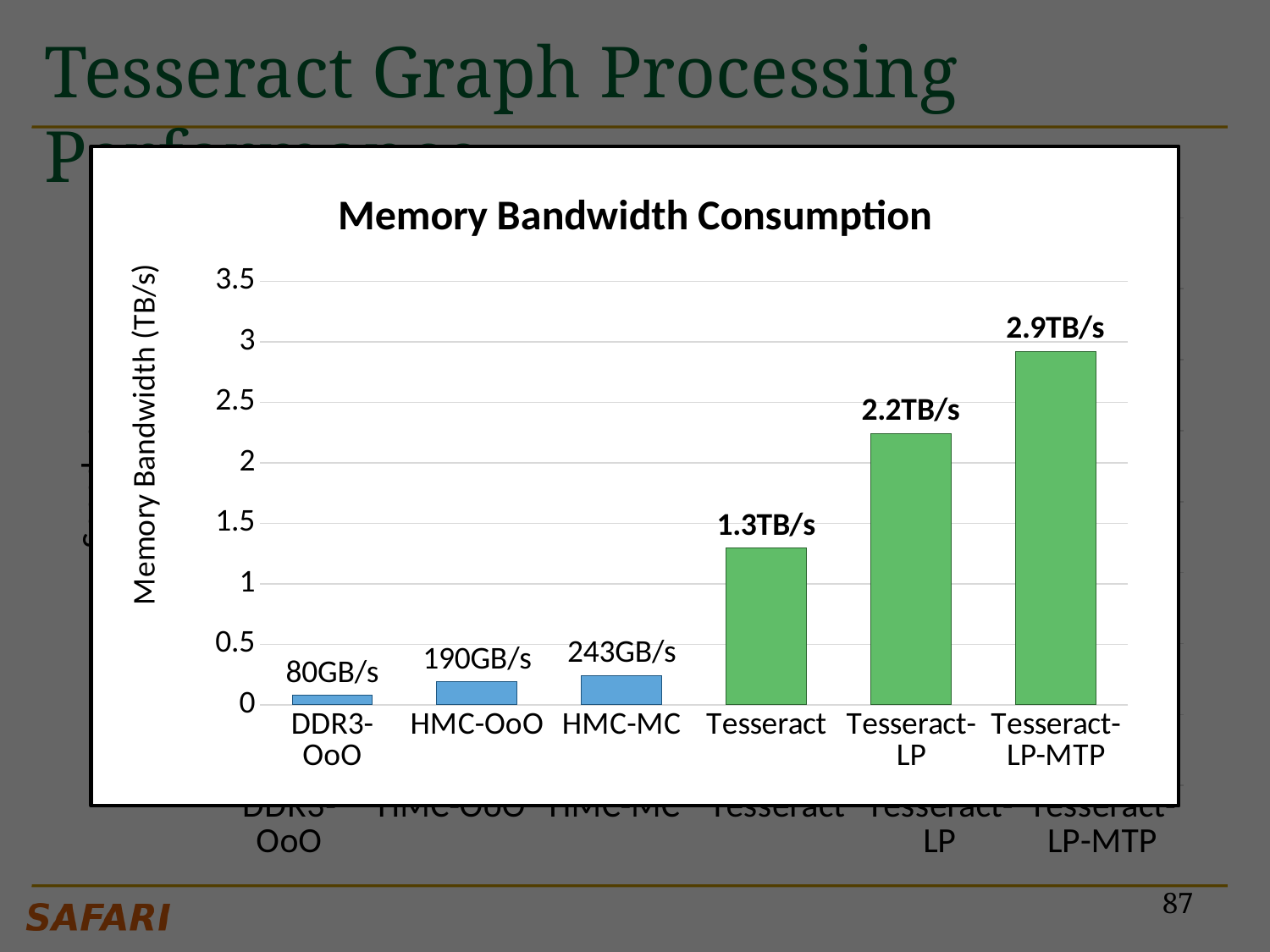
Which has higher memory bandwidth consumption, Tesseract or HMC-MC? Tesseract What kind of chart is used to show Memory Bandwidth Consumption? Bar chart How many configurations are shown on the x axis of the chart? 6 What is the memory bandwidth consumption for Tesseract-LP? 2.2TB/s Which configuration has the lowest memory bandwidth consumption? DDR3-OoO What is the memory bandwidth consumption for HMC-MC? 243GB/s Which configuration has the highest memory bandwidth consumption? Tesseract-LP-MTP What is the label of the y axis of the chart? Memory Bandwidth (TB/s) Is the memory bandwidth for Tesseract greater or less than 1.5 TB/s? less What is the difference in memory bandwidth between Tesseract-LP-MTP and Tesseract-LP? 0.7TB/s What is the difference in memory bandwidth between HMC-MC and HMC-OoO? 53GB/s What is the memory bandwidth consumption for DDR3-OoO? 80GB/s